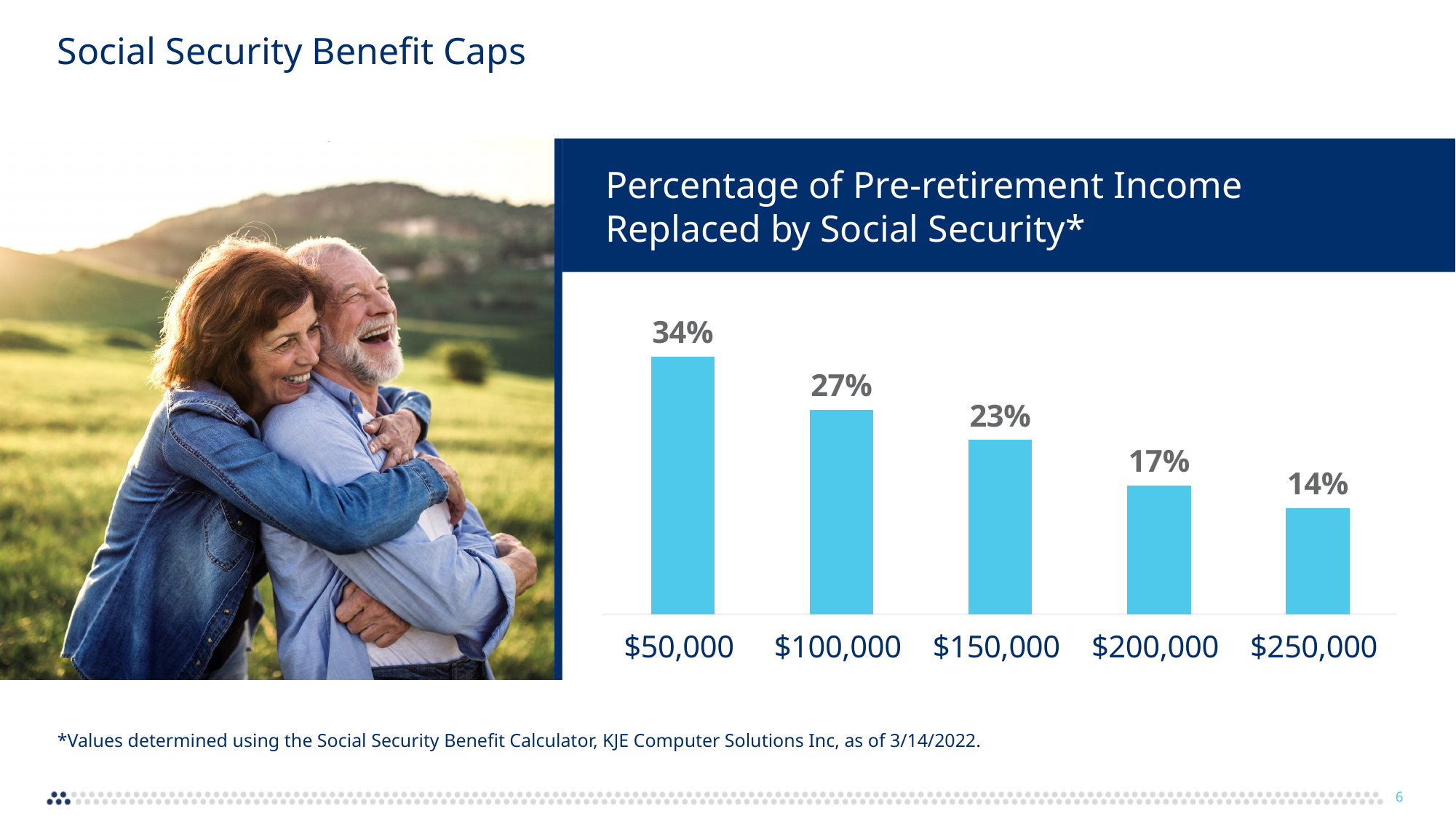
Which has a higher replacement percentage, $100,000 or $200,000? $100,000 Do the replacement percentages rise or fall as pre-retirement income increases along the x axis? Fall How many income levels are shown in the chart? 5 Which income level has the lowest percentage of pre-retirement income replaced by Social Security? $250,000 What kind of chart is shown on the slide? Bar chart What percentage of pre-retirement income is replaced by Social Security at $50,000? 34% What percentage of pre-retirement income is replaced by Social Security at $150,000? 23% What is the title of the chart? Percentage of Pre-retirement Income Replaced by Social Security* Which income level has the highest percentage of pre-retirement income replaced by Social Security? $50,000 What is the difference between the replacement percentage at $50,000 and at $250,000? 20% What is the difference between the replacement percentage at $100,000 and at $200,000? 10% What percentage of pre-retirement income is replaced by Social Security at $250,000? 14%